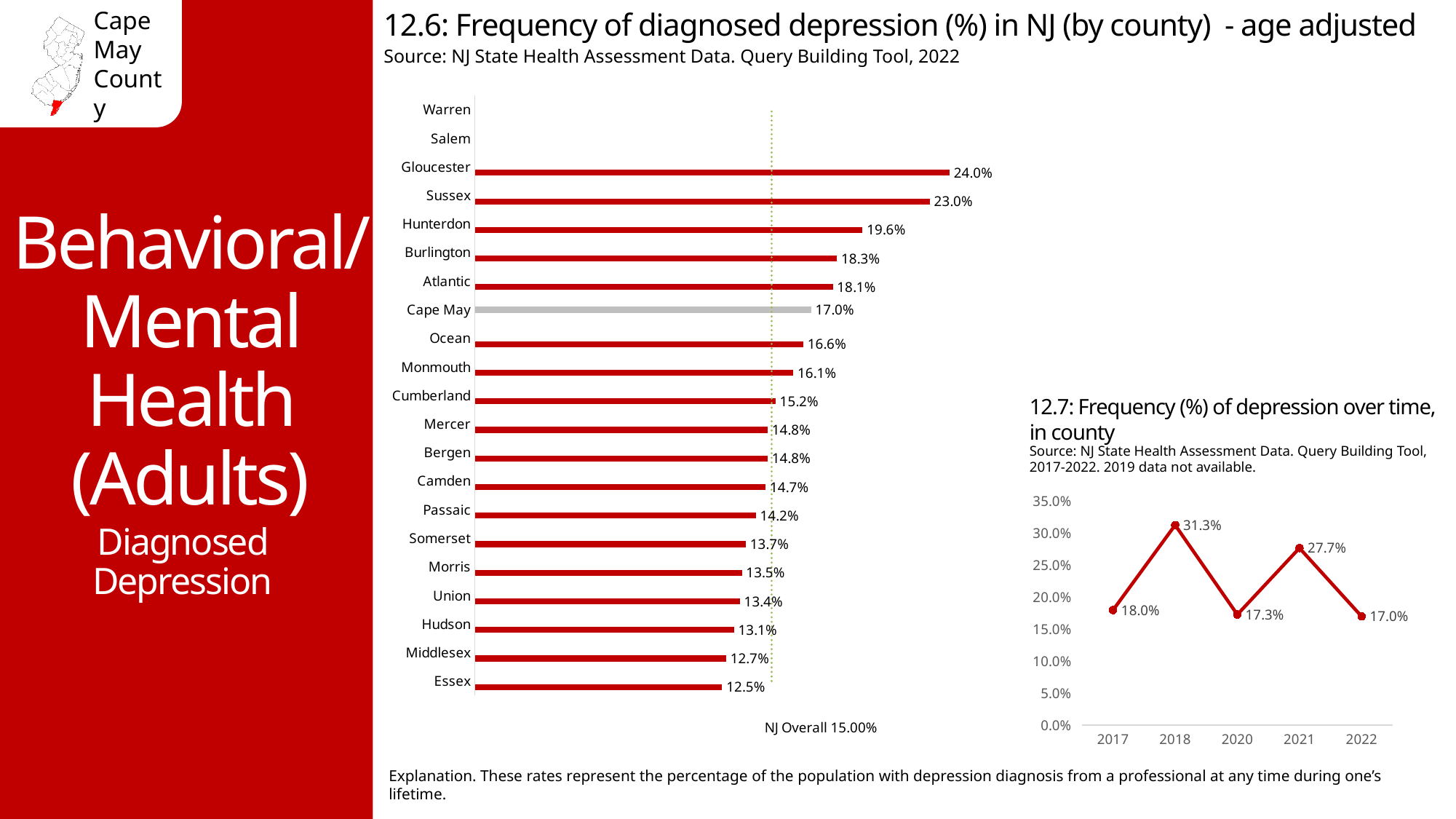
What kind of chart is chart 12.6? Bar chart In chart 12.6, what is the frequency of diagnosed depression for Cape May? 17.0% In chart 12.6, which county has the lowest frequency of diagnosed depression among those with a plotted bar? Essex In chart 12.6, what is the NJ Overall value shown by the dotted reference line? 15.00% In chart 12.6, what is the difference between Gloucester's and Sussex's values? 1.0% In chart 12.7, what is the difference between the 2018 and 2017 values? 13.3% In chart 12.6, which county has the highest frequency of diagnosed depression? Gloucester In chart 12.7, how many data points are plotted on the line? 5 In chart 12.7, which year has the lowest frequency of depression? 2022 In chart 12.6, how many counties are listed on the vertical axis? 21 In chart 12.7, what is the frequency of depression in 2018? 31.3% In chart 12.6, which is larger, the value for Atlantic or the value for Burlington? Burlington